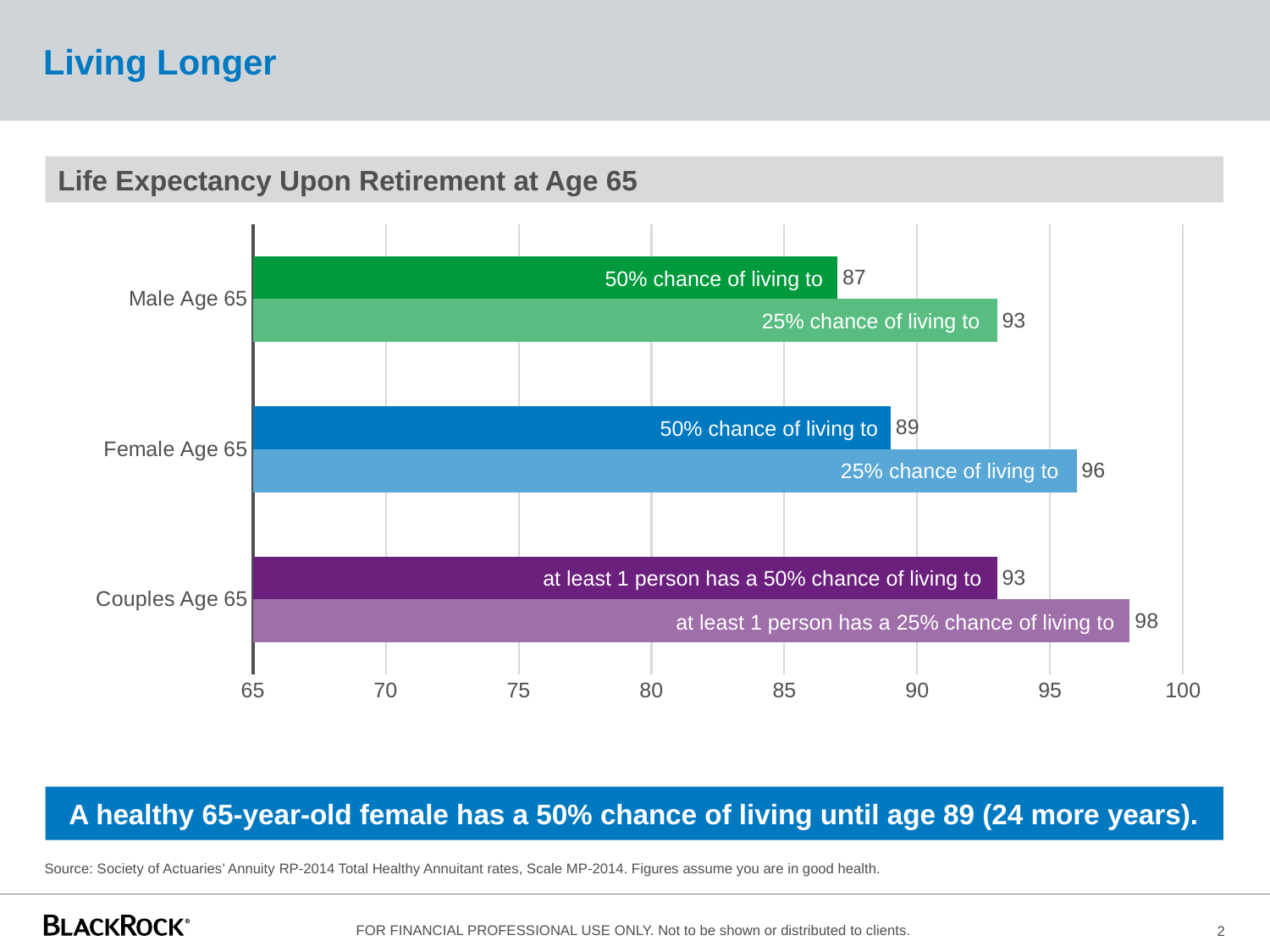
Which category has the highest value on the chart? Couples Age 65 For Couples Age 65, to what age does at least 1 person have a 25% chance of living? 98 What is the title of the chart? Life Expectancy Upon Retirement at Age 65 What age does a Female Age 65 have a 25% chance of living to? 96 What age does a Male Age 65 have a 50% chance of living to? 87 What is the difference between the 50% chance ages for Female Age 65 and Male Age 65? 2 Which category has the lowest value on the chart? Male Age 65 For Couples Age 65, to what age does at least 1 person have a 50% chance of living? 93 Which is larger: the 25% chance age for Male Age 65 or the 50% chance age for Female Age 65? 25% chance age for Male Age 65 What kind of chart is shown on the slide? Bar chart How many categories are shown on the y axis of the chart? 3 What is the difference between the 25% chance and 50% chance ages for Female Age 65? 7